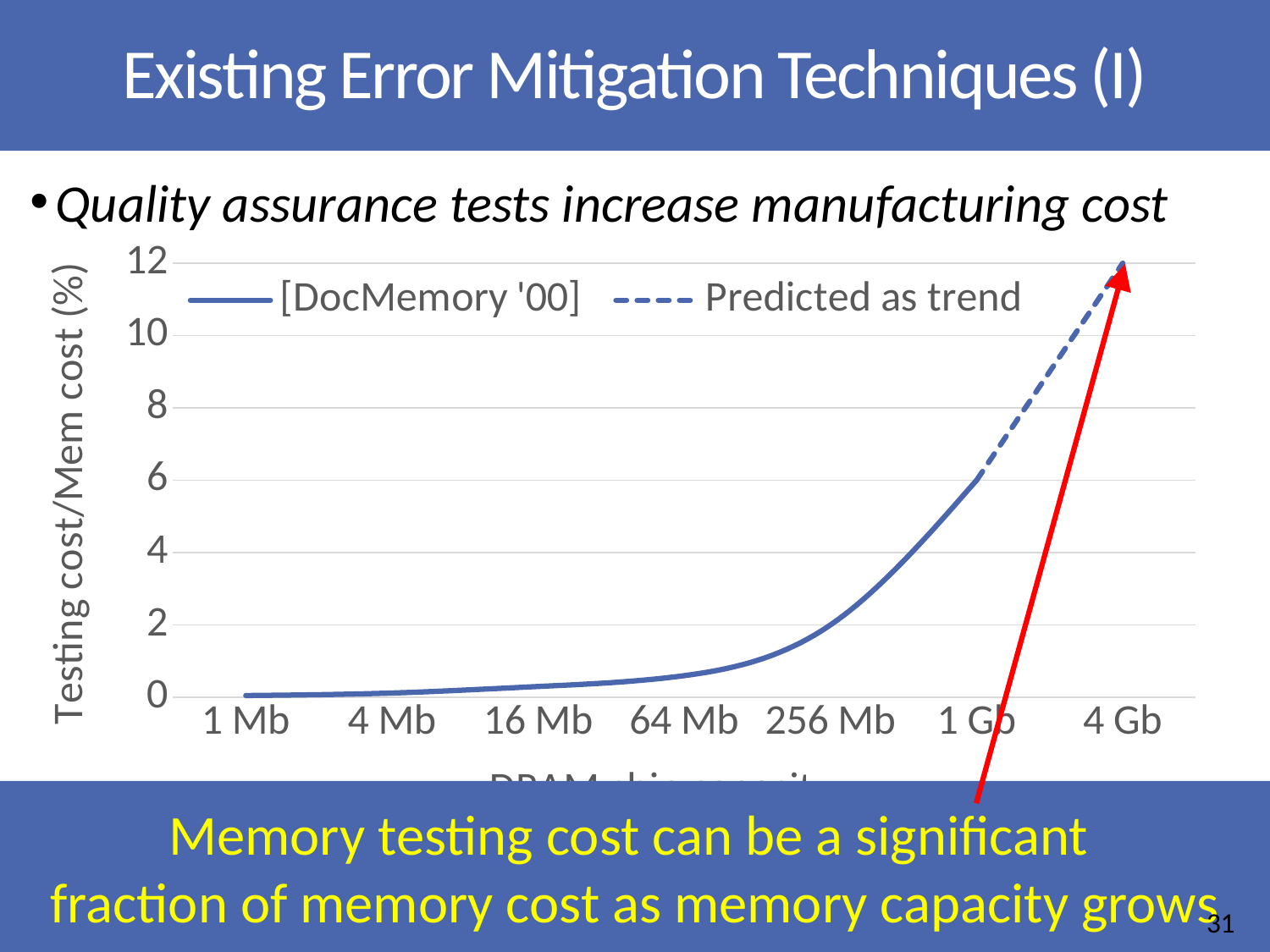
Does the testing cost rise or fall as the chip capacity increases along the x axis? rises Which chip capacity has the highest testing cost on the chart? 4 Gb Which chip capacity has the lowest testing cost on the chart? 1 Mb Is the predicted value for 4 Gb greater or less than 10? greater What kind of chart is shown on the slide? line chart Is the value for 1 Mb greater or less than 2? less Which has the larger testing cost, 64 Mb or 1 Gb? 1 Gb How many series does the chart legend list? 2 What is the label of the y axis? Testing cost/Mem cost (%) How many DRAM chip capacity categories are shown on the x axis? 7 Is the value for 1 Gb greater or less than 4? greater